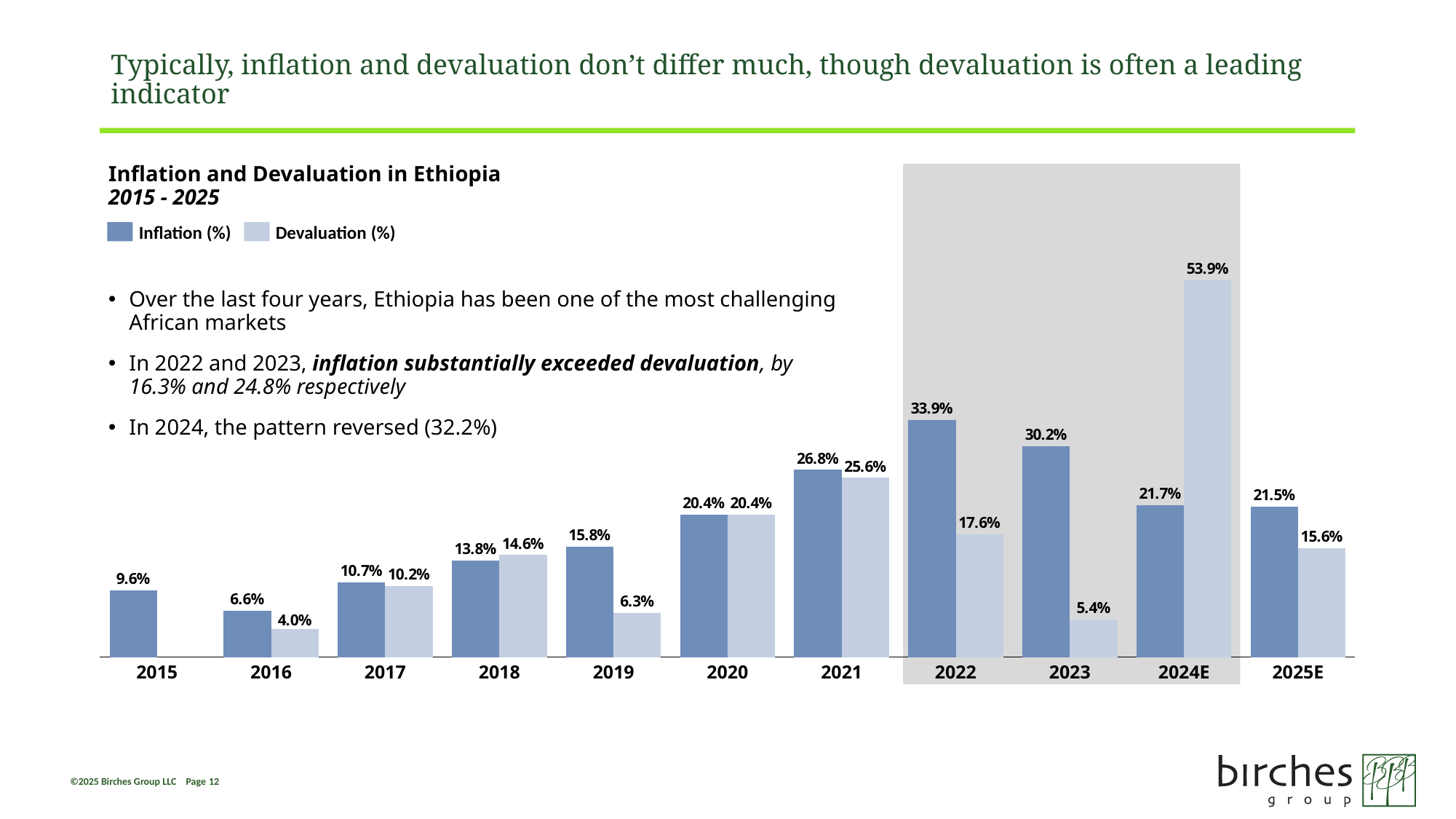
Which is larger in 2018, Inflation (%) or Devaluation (%)? Devaluation (%) What is the title of the chart? Inflation and Devaluation in Ethiopia 2015 - 2025 What is the difference between Inflation (%) and Devaluation (%) in 2023? 24.8% How many years are shown on the x axis? 11 Which year has the highest Inflation (%) value? 2022 Which year has the lowest Devaluation (%) value among those with a devaluation bar? 2016 What is the Devaluation (%) value for 2024E? 53.9% What is the Devaluation (%) value for 2019? 6.3% Which years are highlighted with a grey shaded background on the chart? 2022, 2023 and 2024E What kind of chart is shown on the slide? Bar chart How many series does the legend list? 2 What is the Inflation (%) value for 2022? 33.9%